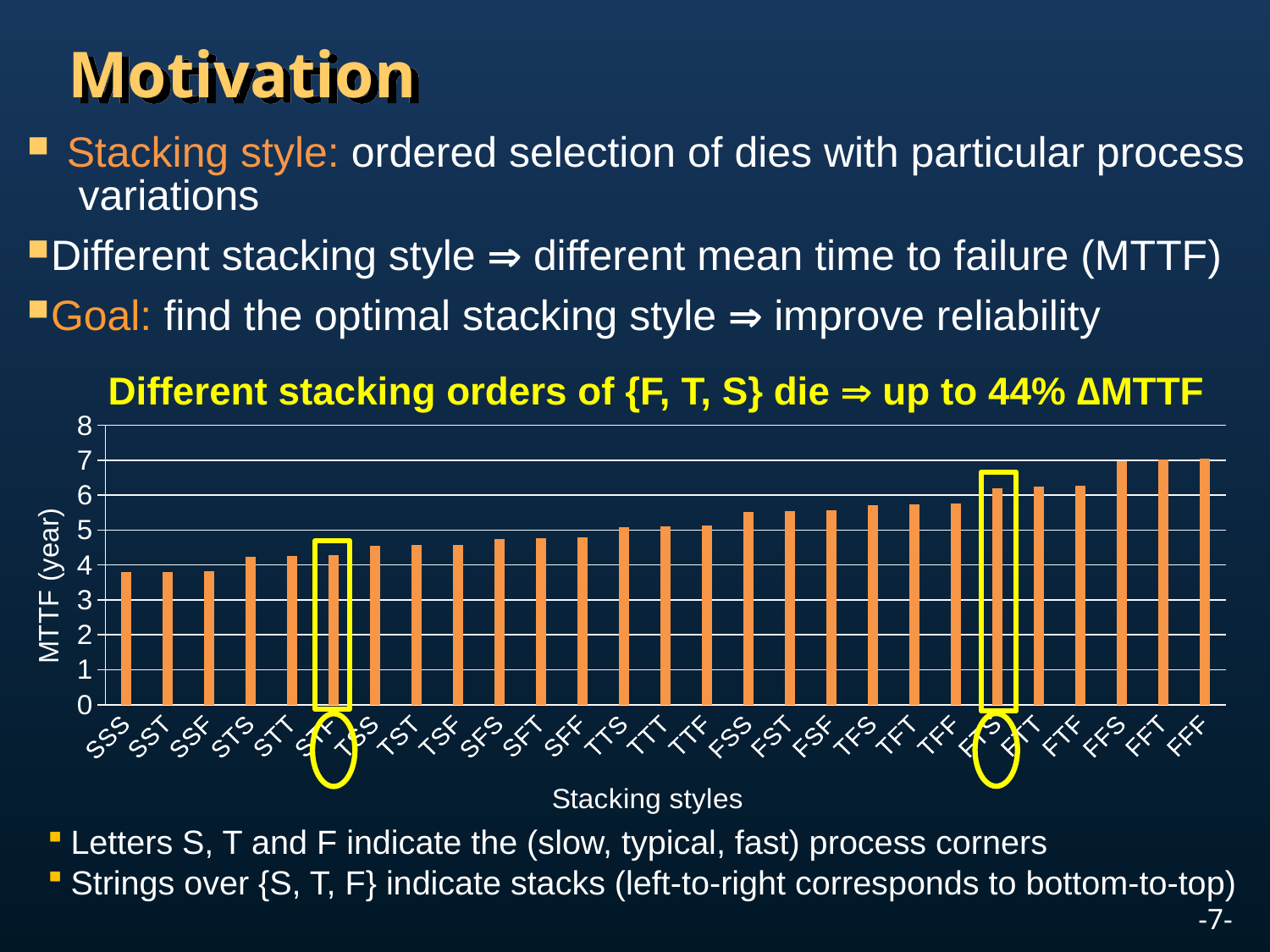
How many stacking styles are plotted along the x axis of the chart? 27 Is the MTTF value for SSS greater or less than 4? less Is the MTTF value for FFF greater or less than 6? greater Do the MTTF values generally rise or fall from left to right along the x axis? rise Is the MTTF value for FTS greater or less than 5? greater What is the label of the y axis of the chart? MTTF (year) Which has a higher MTTF, FFF or SSS? FFF What is the label of the x axis of the chart? Stacking styles Which has a higher MTTF, SSF or TTT? TTT What kind of chart is shown on the slide? bar chart